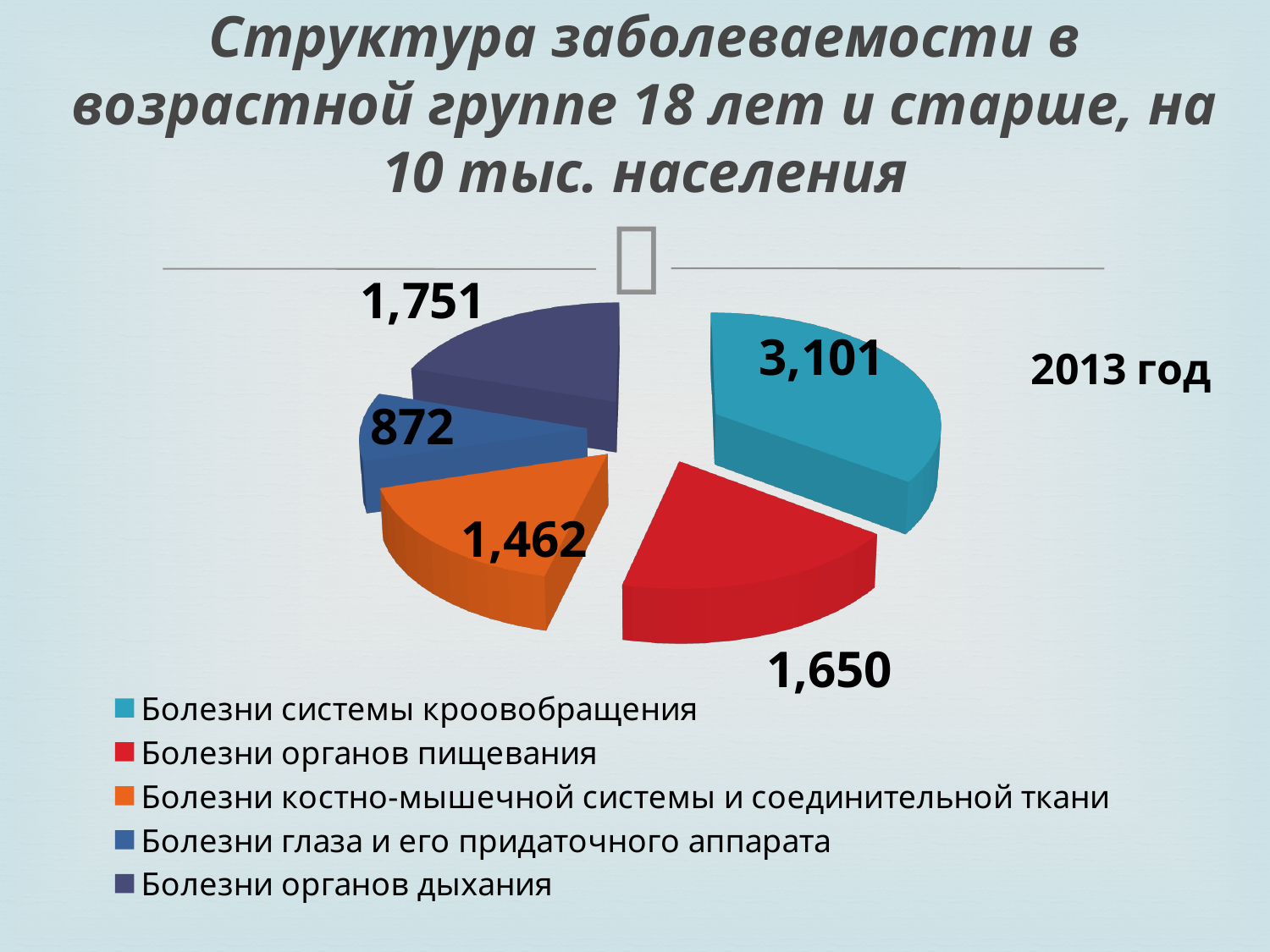
What is the value for Болезни костно-мышечной системы и соединительной ткани? 1,462 What is the value for Болезни органов дыхания? 1,751 What is the value for Болезни глаза и его придаточного аппарата? 872 How many slices does the pie chart have? 5 Which category has the smallest slice of the pie? Болезни глаза и его придаточного аппарата What is the difference between the values for Болезни системы кроовобращения and Болезни органов дыхания? 1,350 What is the total of all the slices in the pie chart? 8,836 Which is larger: the value for Болезни органов дыхания or the value for Болезни органов пищевания? Болезни органов дыхания Which year is the pie chart labelled with? 2013 год Which category has the largest slice of the pie? Болезни системы кроовобращения What is the value for Болезни системы кроовобращения? 3,101 What kind of chart is shown on the slide? Pie chart